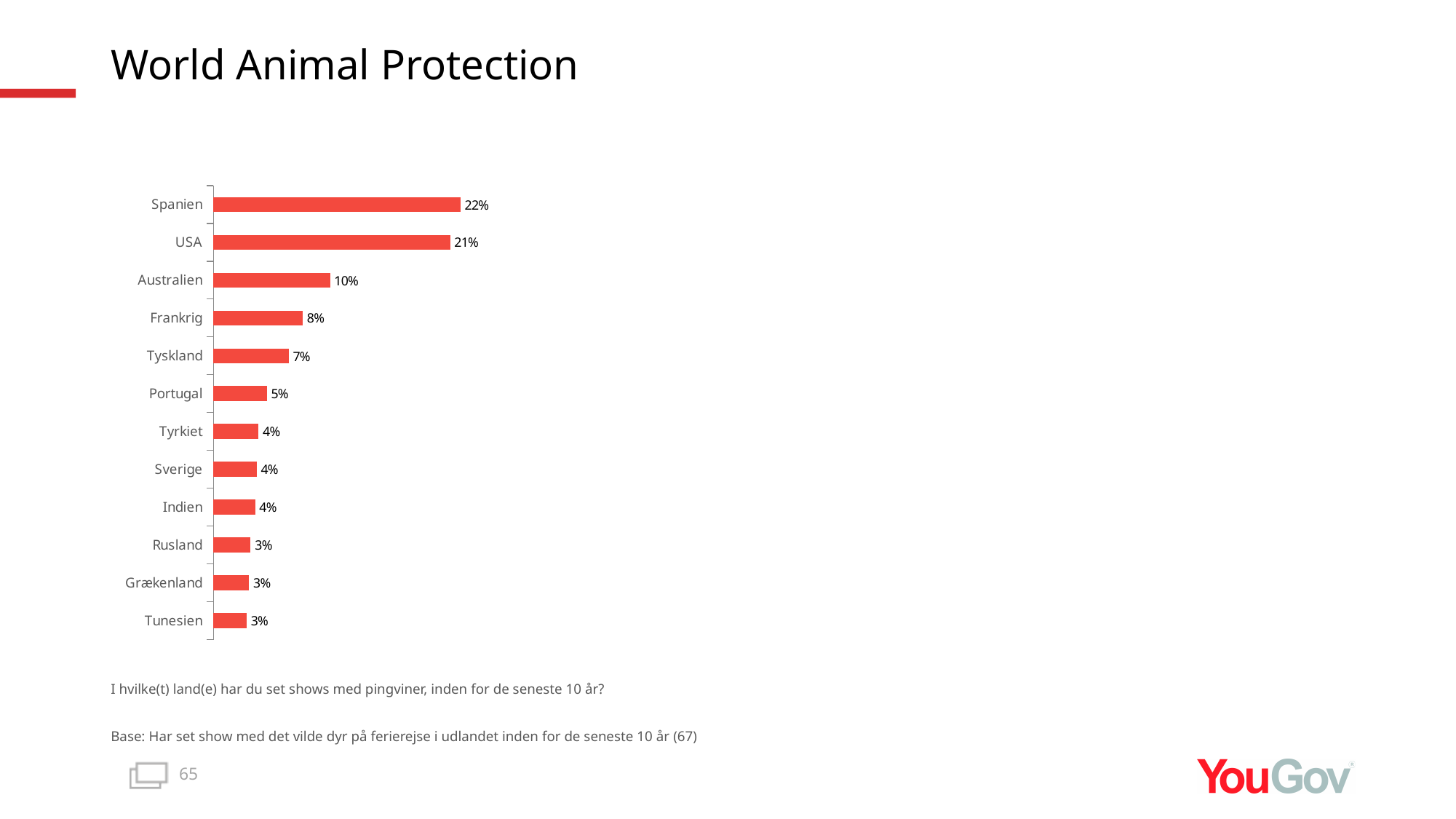
What is the value for Portugal? 5% What is the difference between the values for Australien and Frankrig? 2% What kind of chart is shown on the slide? Bar chart What is the value for Tyskland? 7% Which is larger, the value for USA or the value for Australien? USA How many countries are shown in the chart? 12 Which is larger, the value for Frankrig or the value for Portugal? Frankrig What is the difference between the values for Spanien and USA? 1% What colour are the bars in the chart? Red What is the value for Australien? 10% What is the value for Spanien? 22% Which country has the highest value? Spanien